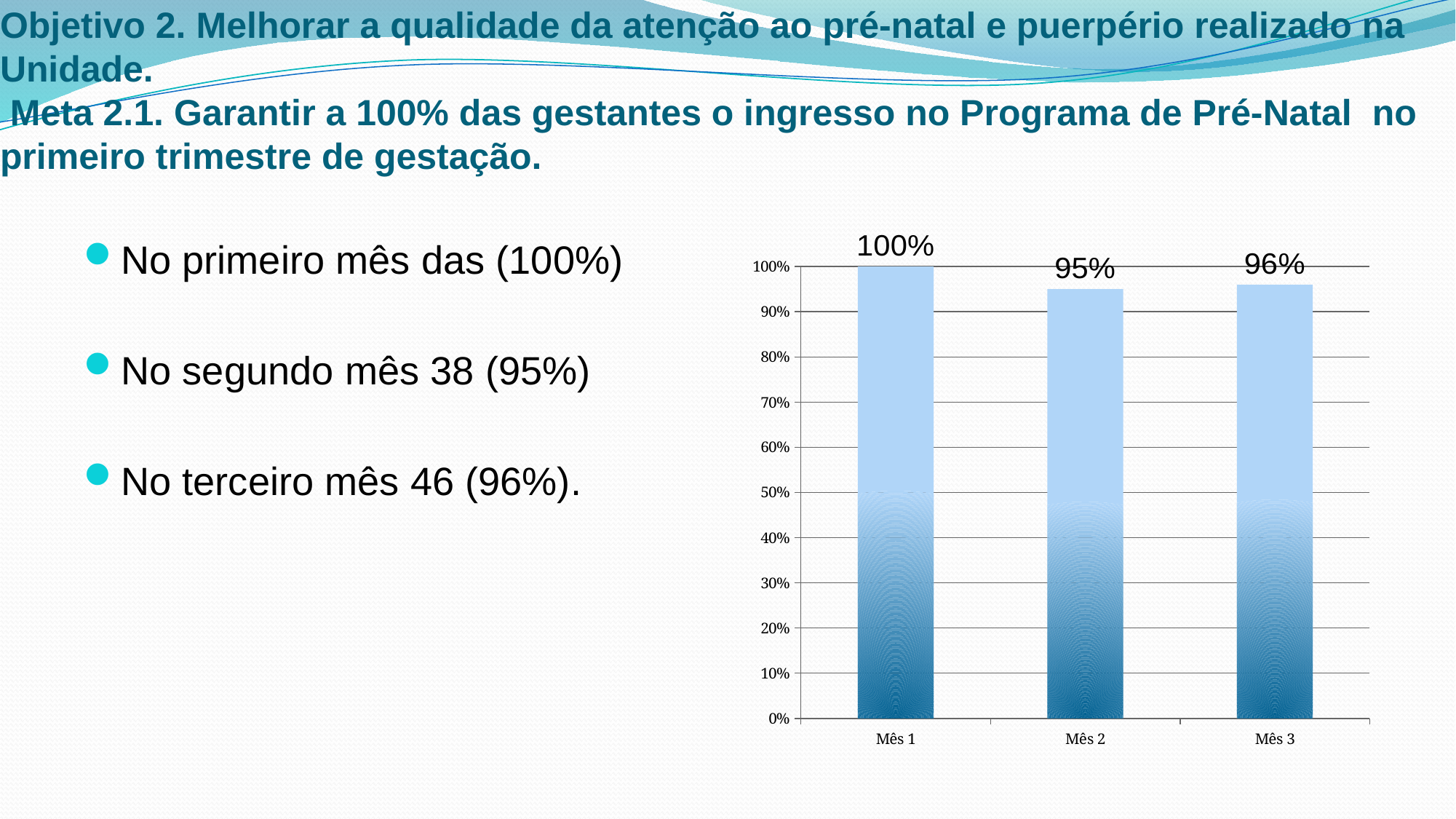
What kind of chart is shown on the slide? bar chart What is the difference between the values for Mês 3 and Mês 2? 1% What is the highest value shown on the vertical axis? 100% Which month has the lowest value? Mês 2 What is the value for Mês 3? 96% Is the value for Mês 2 greater or less than 90%? greater What is the value for Mês 1? 100% What is the difference between the values for Mês 1 and Mês 2? 5% How many months are shown on the chart? 3 Which is larger, the value for Mês 1 or the value for Mês 3? Mês 1 Which month has the highest value? Mês 1 What is the value for Mês 2? 95%